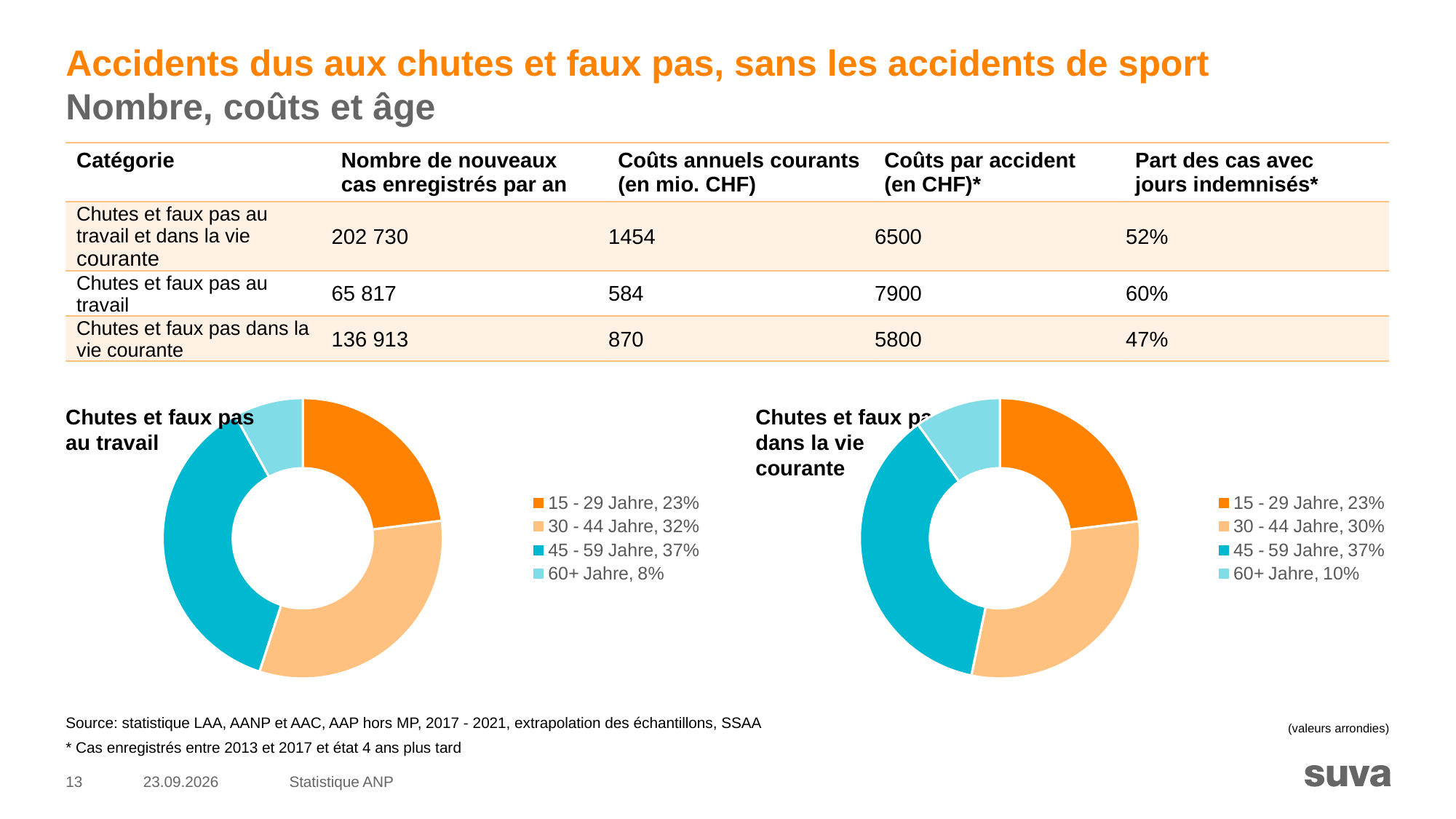
In the 'Chutes et faux pas au travail' chart, which colour represents 15 - 29 Jahre? Orange Is the share of 60+ Jahre larger in the 'Chutes et faux pas au travail' chart or in the 'Chutes et faux pas dans la vie courante' chart? Chutes et faux pas dans la vie courante What kind of chart is 'Chutes et faux pas dans la vie courante'? Donut (pie) chart In the 'Chutes et faux pas au travail' chart, what is the difference between the shares of 30 - 44 Jahre and 15 - 29 Jahre? 9 percentage points In the 'Chutes et faux pas dans la vie courante' chart, what share is shown for 60+ Jahre? 10% In the 'Chutes et faux pas au travail' chart, what share is shown for 45 - 59 Jahre? 37% In the 'Chutes et faux pas au travail' chart, what share is shown for 60+ Jahre? 8% In the 'Chutes et faux pas dans la vie courante' chart, what share is shown for 30 - 44 Jahre? 30% How many age groups does the 'Chutes et faux pas au travail' chart show? 4 In the 'Chutes et faux pas dans la vie courante' chart, what is the difference between the shares of 45 - 59 Jahre and 60+ Jahre? 27 percentage points In the 'Chutes et faux pas dans la vie courante' chart, which age group has the smallest share? 60+ Jahre In the 'Chutes et faux pas au travail' chart, which age group has the largest share? 45 - 59 Jahre